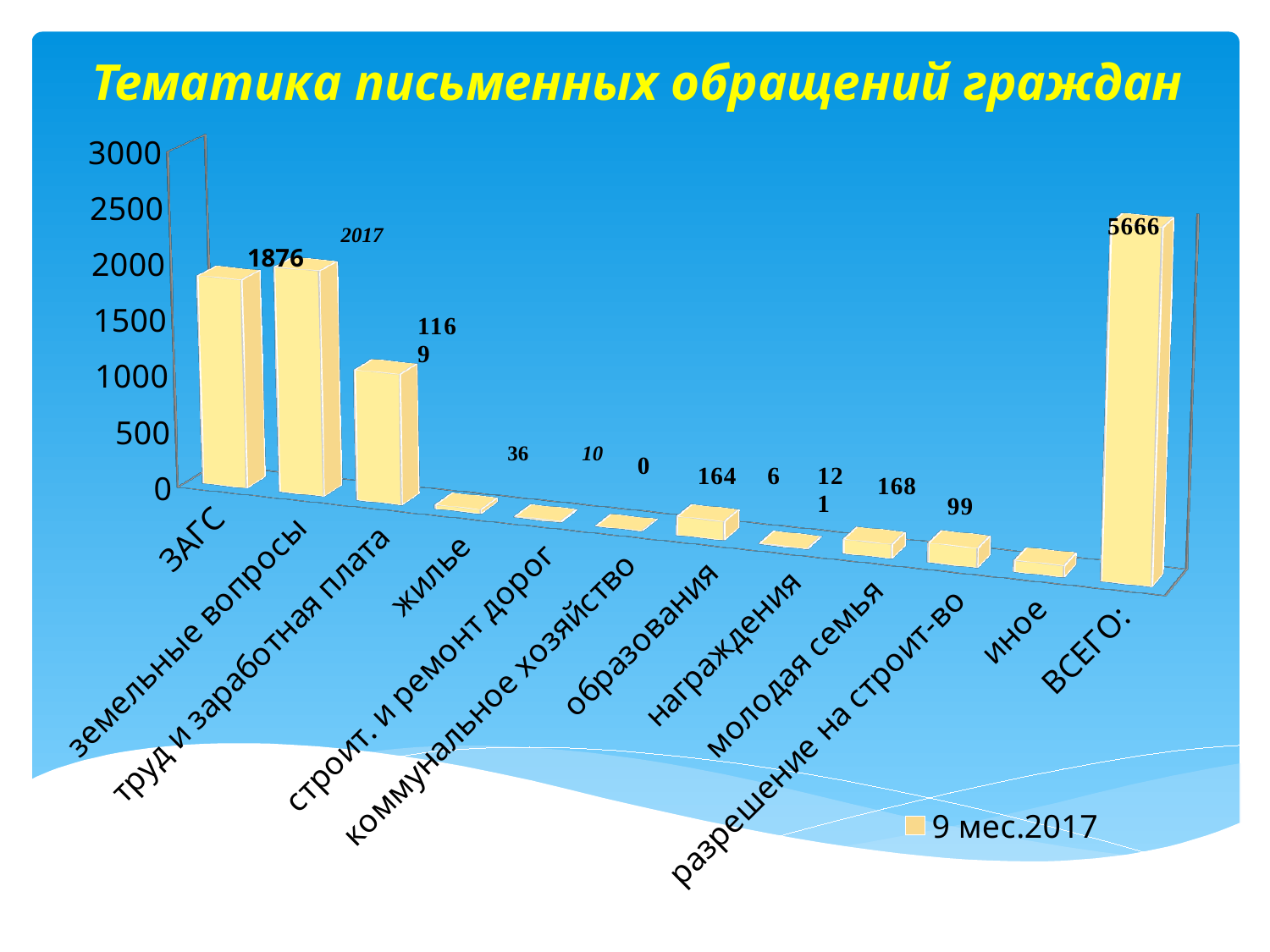
What is the value for ЗАГС? 1876 What is the value for образования? 164 What is the value for коммунальное хозяйство? 0 What is the value for иное? 99 What is the legend entry shown on the chart? 9 мес.2017 How many categories are shown on the x axis? 12 Which is larger, the value for образования or the value for разрешение на строит-во? разрешение на строит-во What is the difference between the values for земельные вопросы and ЗАГС? 141 Which category has the lowest value? коммунальное хозяйство What is the value for ВСЕГО:? 5666 What kind of chart is shown on the slide? bar chart What is the value for земельные вопросы? 2017